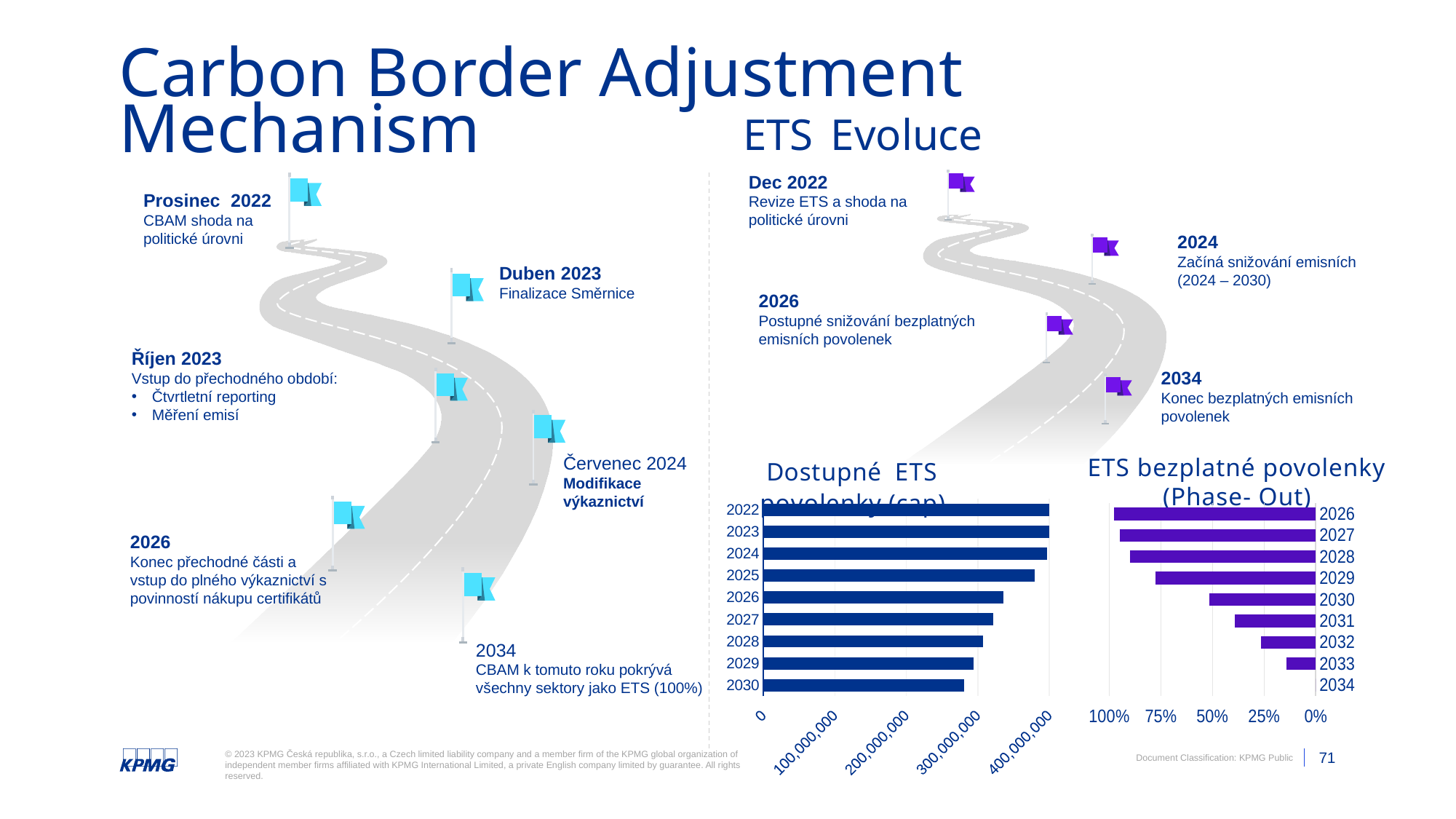
In the 'ETS bezplatné povolenky (Phase-Out)' chart, which is larger, the value for 2028 or the value for 2032? 2028 In the 'Dostupné ETS povolenky (cap)' chart, is the value for 2026 greater or less than 300,000,000? greater In the 'ETS bezplatné povolenky (Phase-Out)' chart, which year has the lowest value? 2034 In the 'Dostupné ETS povolenky (cap)' chart, is the value for 2030 greater or less than 300,000,000? less How many years are shown in the 'Dostupné ETS povolenky (cap)' chart? 9 How many years are listed in the 'ETS bezplatné povolenky (Phase-Out)' chart? 9 In the 'Dostupné ETS povolenky (cap)' chart, which is larger, the value for 2025 or the value for 2028? 2025 In the 'ETS bezplatné povolenky (Phase-Out)' chart, is the value for 2031 greater or less than 50%? less What kind of chart is the 'Dostupné ETS povolenky (cap)' chart? bar chart In the 'Dostupné ETS povolenky (cap)' chart, which year has the lowest value? 2030 In the 'Dostupné ETS povolenky (cap)' chart, do the values rise or fall from 2022 to 2030? fall